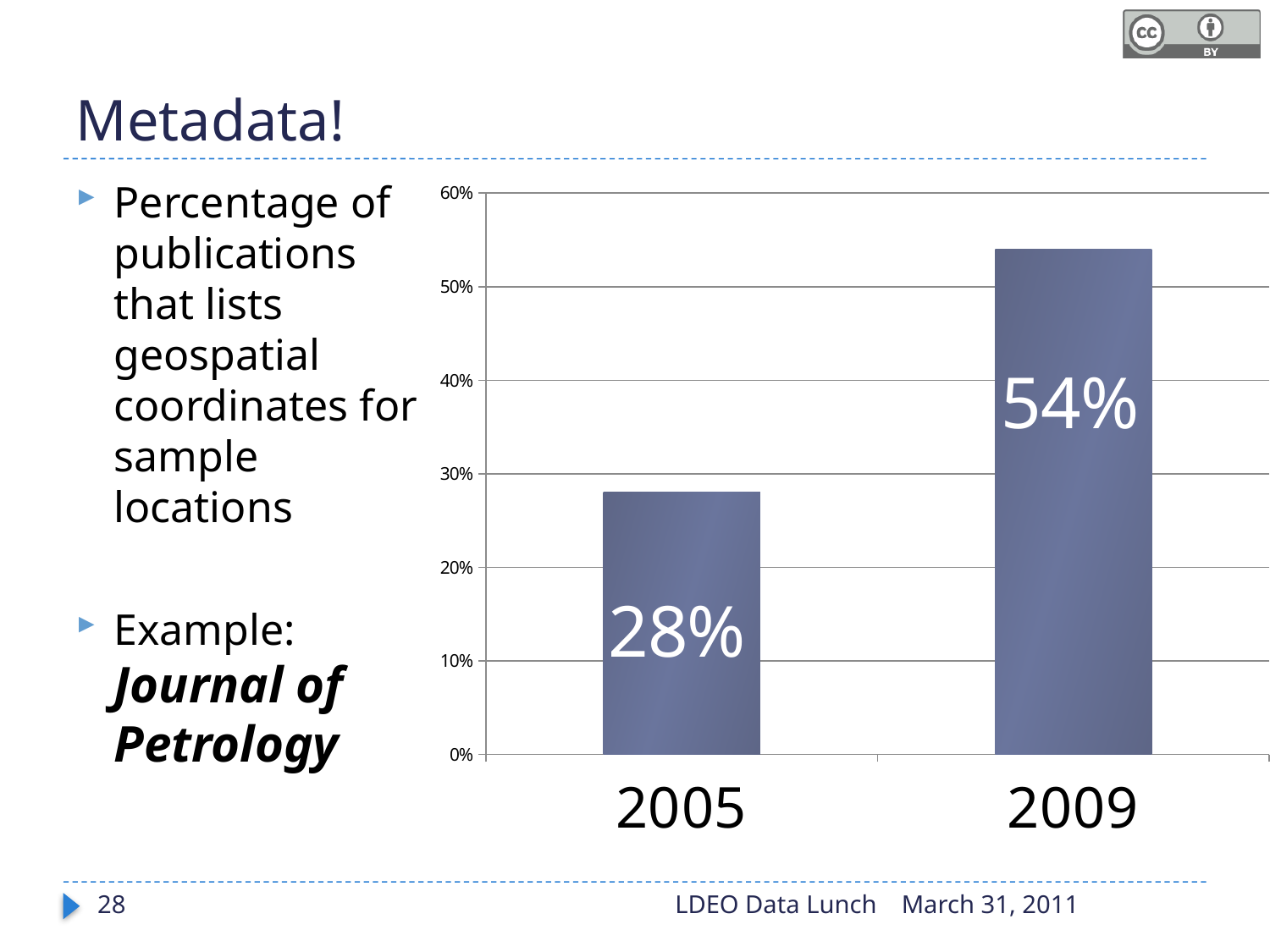
What is the value for 2005? 28% Is the value for 2005 greater or less than 30%? less Which is larger, the value for 2005 or the value for 2009? 2009 Is the value for 2009 greater or less than 50%? greater What kind of chart is shown on the slide? bar chart What is the maximum value shown on the y axis? 60% Which year has the lowest value? 2005 Do the values rise or fall from 2005 to 2009? rise What is the value for 2009? 54% What is the difference between the values for 2009 and 2005? 26% Which year has the highest value? 2009 How many categories are shown on the x axis? 2